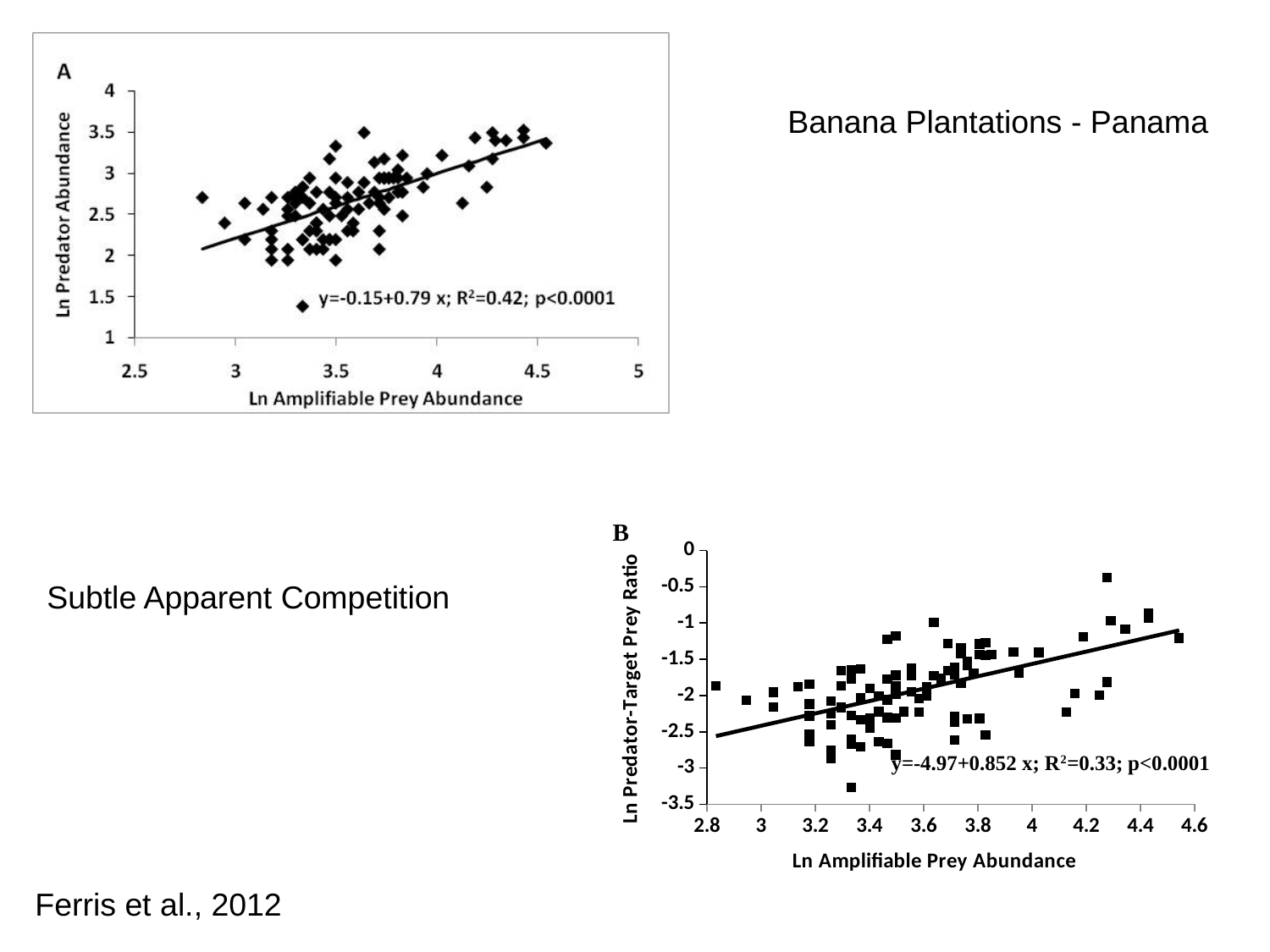
What is the difference between the R² values printed on chart A and chart B? 0.09 In chart B, is the lowest plotted point's y value greater or less than -3? less What is the R² value printed on chart A? 0.42 What is the y-axis title of chart B? Ln Predator-Target Prey Ratio What regression equation is printed on chart A? y=-0.15+0.79 x What kind of chart is chart A (top left)? scatter plot In chart B, does Ln Predator-Target Prey Ratio tend to rise or fall as Ln Amplifiable Prey Abundance increases? rise Which chart reports the higher R² value, chart A or chart B? chart A In chart A, does Ln Predator Abundance tend to rise or fall as Ln Amplifiable Prey Abundance increases? rise What kind of chart is chart B (bottom right)? scatter plot What is the R² value printed on chart B? 0.33 What regression equation is printed on chart B? y=-4.97+0.852 x